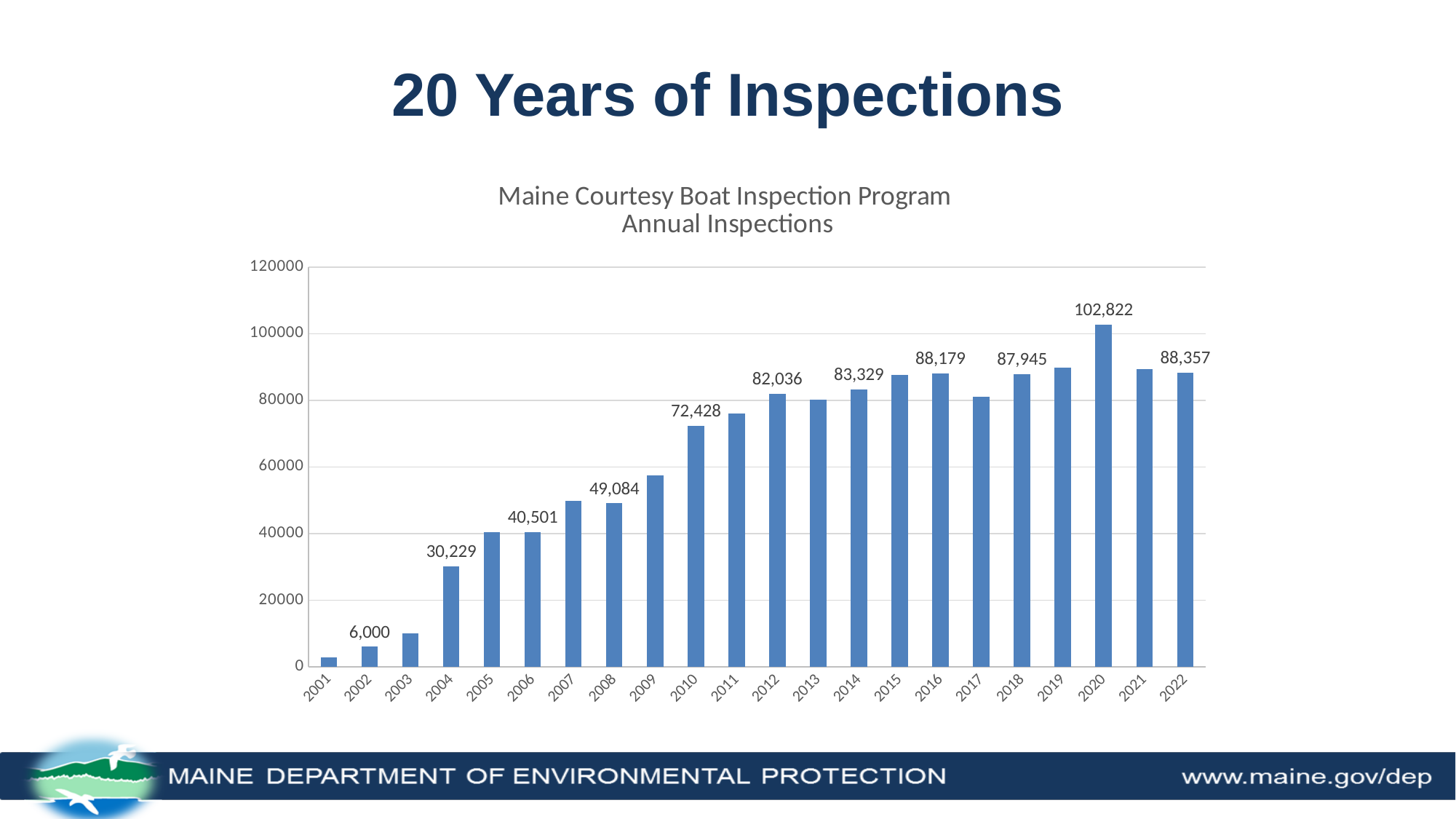
Which is larger, the value for 2016 or the value for 2018? 2016 What is the value for 2020? 102,822 What is the value for 2002? 6,000 What is the difference between the values for 2020 and 2022? 14,465 What is the difference between the values for 2004 and 2002? 24,229 How many years are shown on the x axis? 22 Which year has the lowest number of inspections? 2001 What kind of chart is shown on the slide? Bar chart What is the value for 2010? 72,428 Which year has the highest number of inspections? 2020 What is the value for 2022? 88,357 Is the value for 2009 greater or less than 60000? less